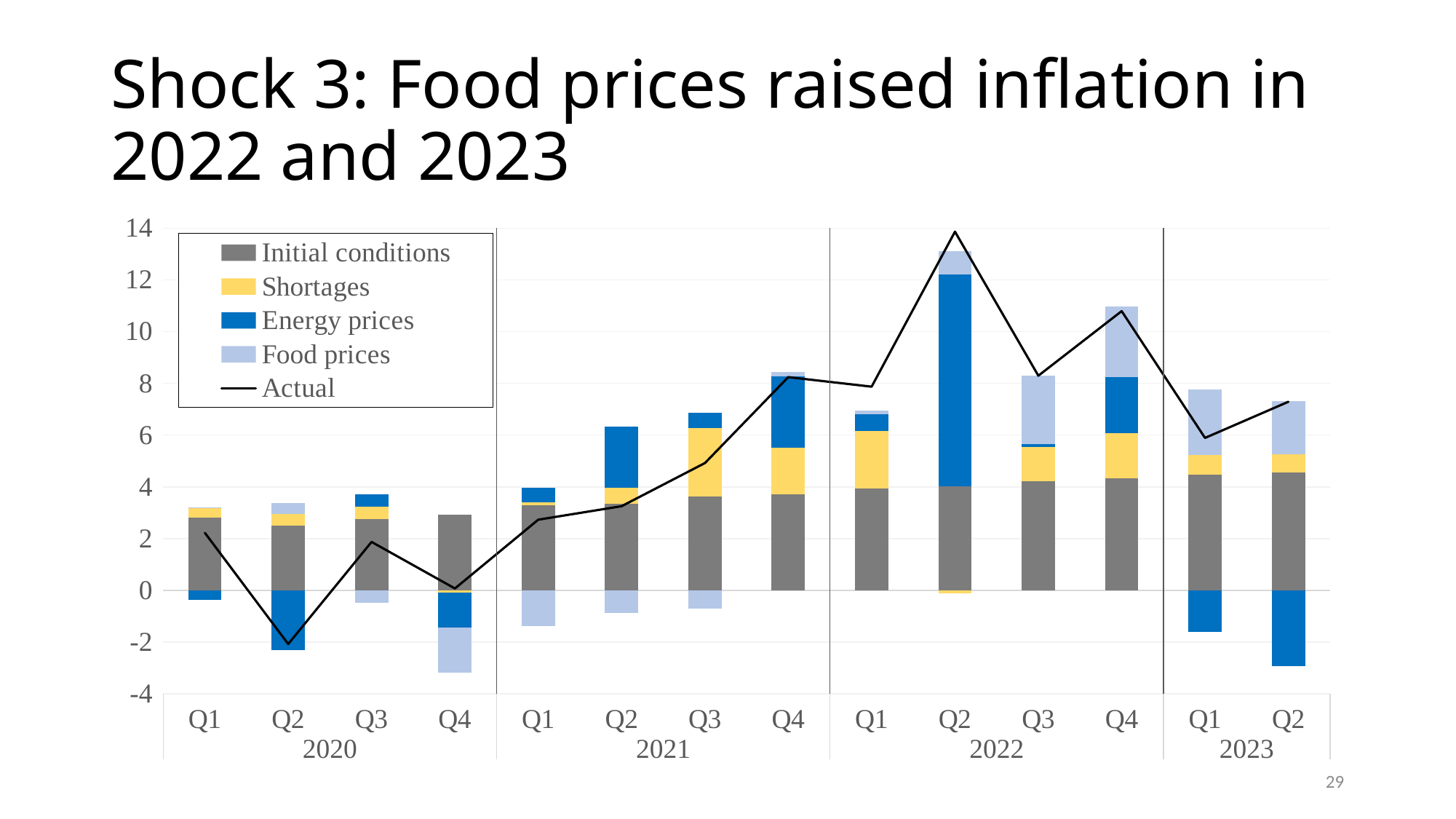
Does the Actual line rise or fall from Q1 2021 to Q4 2021? rise What is the title of the slide? Shock 3: Food prices raised inflation in 2022 and 2023 Which series is drawn as a line rather than as bars? Actual Is the Actual value for Q2 2023 greater or less than 6? greater How many series does the legend list? 5 Is the Actual value for Q2 2020 greater or less than 0? less Is the Actual value for Q2 2022 greater or less than 12? greater In which quarter does the Actual line reach its lowest value? Q2 2020 What kind of chart is shown on the slide? A stacked bar chart with a line Which is larger, the Actual value for Q1 2021 or for Q1 2022? Q1 2022 How many quarters are plotted along the x axis? 14 In which quarter does the Actual line reach its highest value? Q2 2022